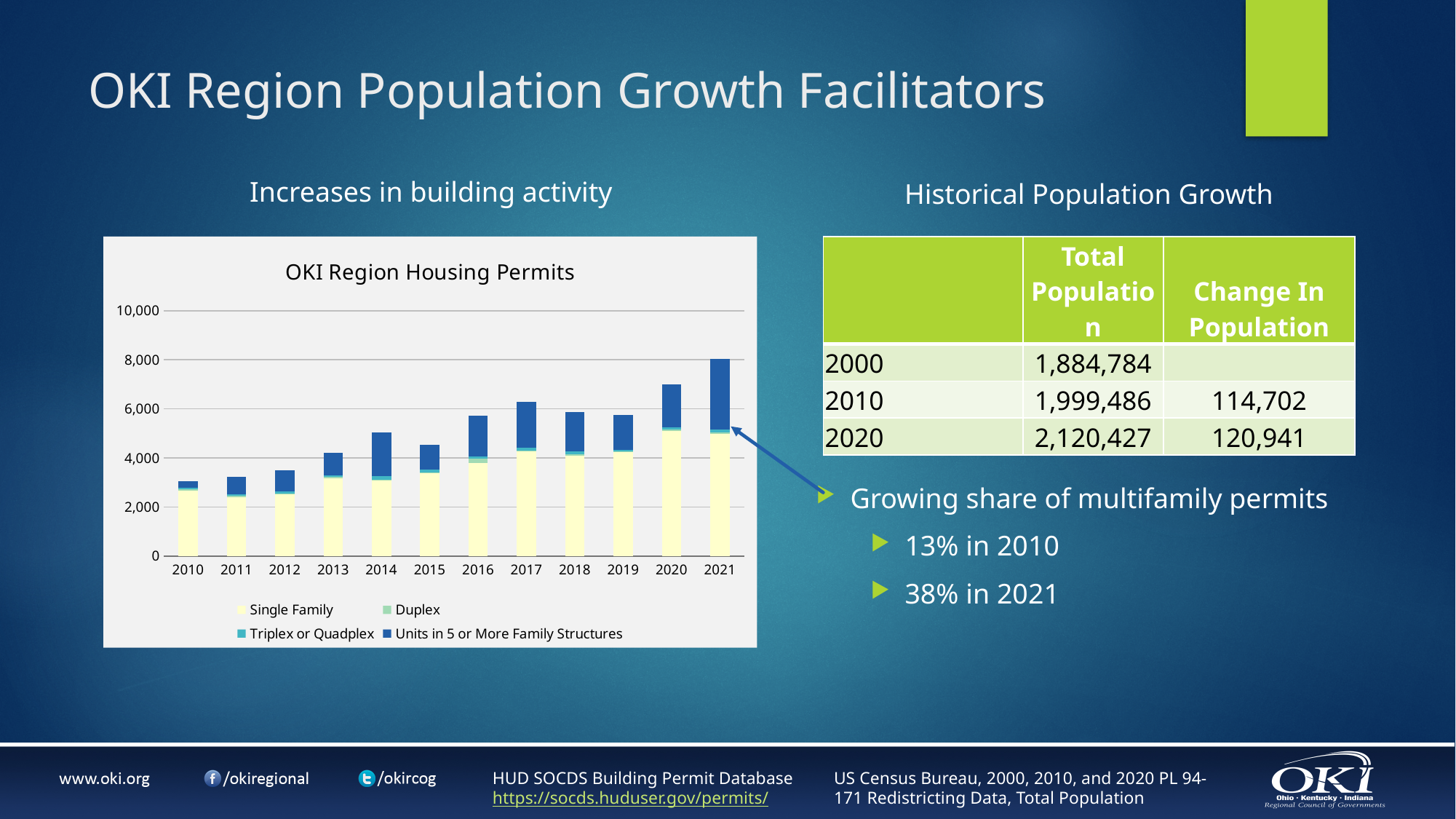
Is the total for 2021 in the OKI Region Housing Permits chart greater or less than 6,000? greater Which series makes up the largest portion of each bar in the OKI Region Housing Permits chart? Single Family What kind of chart is the OKI Region Housing Permits chart? bar chart What is the title of the chart on the slide? OKI Region Housing Permits Do total housing permits generally rise or fall from 2010 to 2021 in the OKI Region Housing Permits chart? rise Is the total for 2015 in the OKI Region Housing Permits chart greater or less than 6,000? less Is the total for 2014 in the OKI Region Housing Permits chart greater or less than 4,000? greater How many years are shown on the x axis of the OKI Region Housing Permits chart? 12 Which year has the highest total housing permits in the OKI Region Housing Permits chart? 2021 How many series does the legend of the OKI Region Housing Permits chart list? 4 In the OKI Region Housing Permits chart, which year has the larger total, 2019 or 2020? 2020